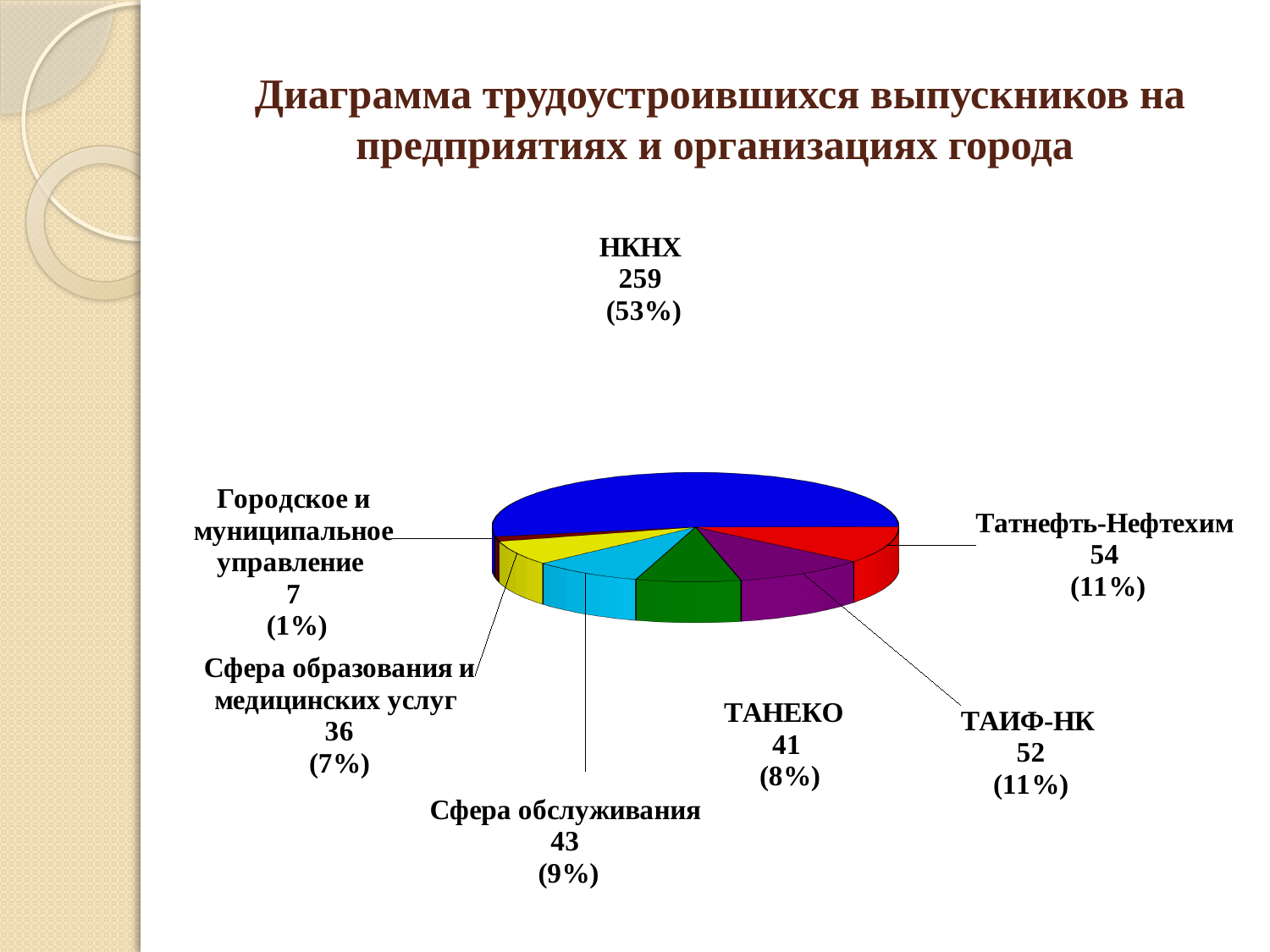
What is the value for Сфера обслуживания? 43 What is the value for Городское и муниципальное управление? 7 What is the difference between the values for Татнефть-Нефтехим and ТАИФ-НК? 2 What type of chart is shown on the slide? Pie chart What is the value for НКНХ? 259 How many slices does the pie chart have? 7 Which category has the largest slice of the pie? НКНХ What share of the pie does ТАНЕКО represent? 8% What share of the pie does Сфера образования и медицинских услуг represent? 7% Which is larger, the value for Сфера обслуживания or the value for ТАНЕКО? Сфера обслуживания Which category has the smallest slice of the pie? Городское и муниципальное управление What is the value for Татнефть-Нефтехим? 54